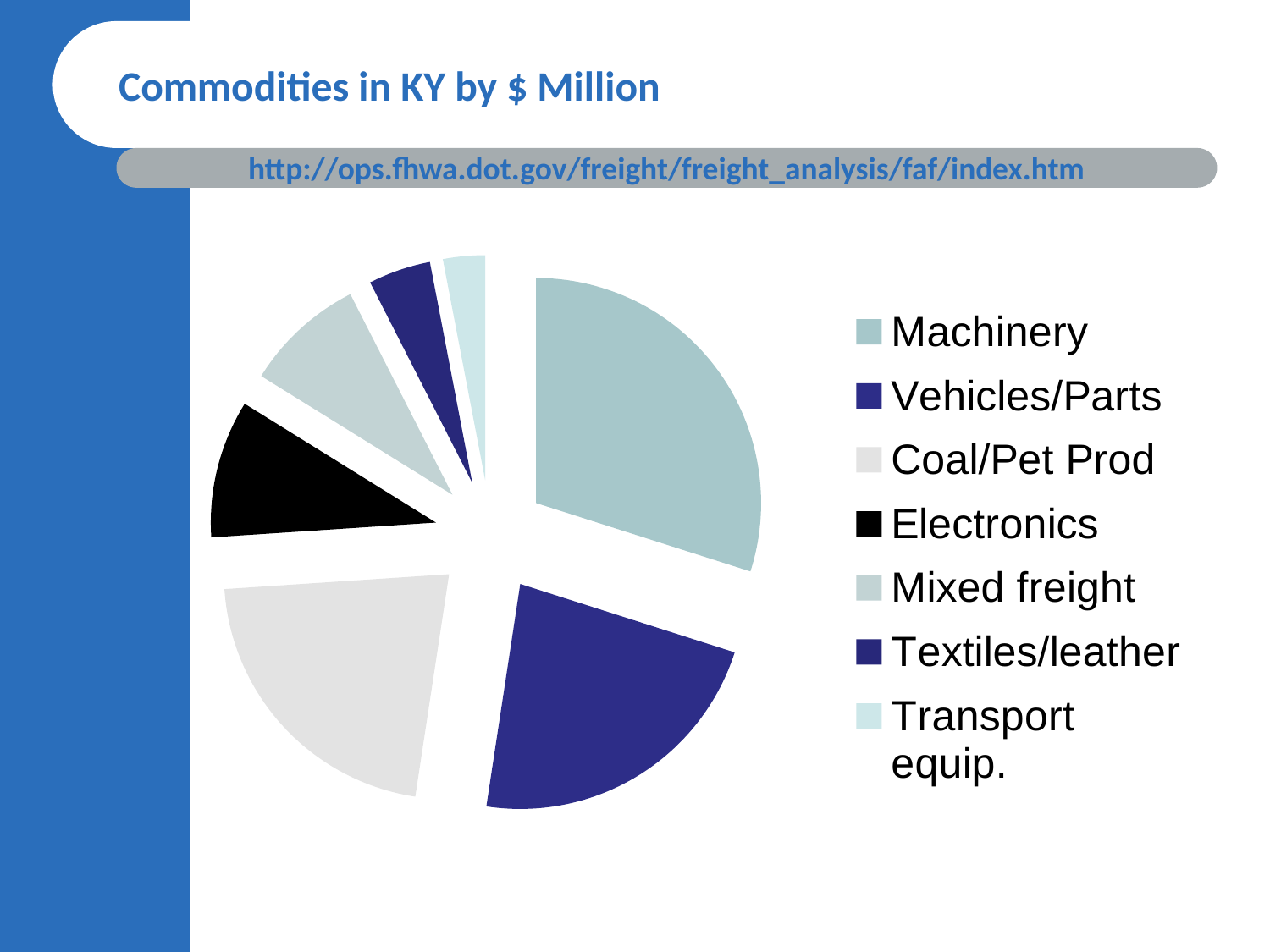
How many commodity categories (slices) does the pie chart show? 7 What colour is the Electronics slice in the pie chart? black Which slice is larger, Machinery or Electronics? Machinery Which slice is larger, Coal/Pet Prod or Mixed freight? Coal/Pet Prod What is the title of the slide containing the pie chart? Commodities in KY by $ Million Which slice is larger, Mixed freight or Textiles/leather? Mixed freight What kind of chart is shown on the slide? pie chart Which commodity has the largest slice of the pie chart? Machinery